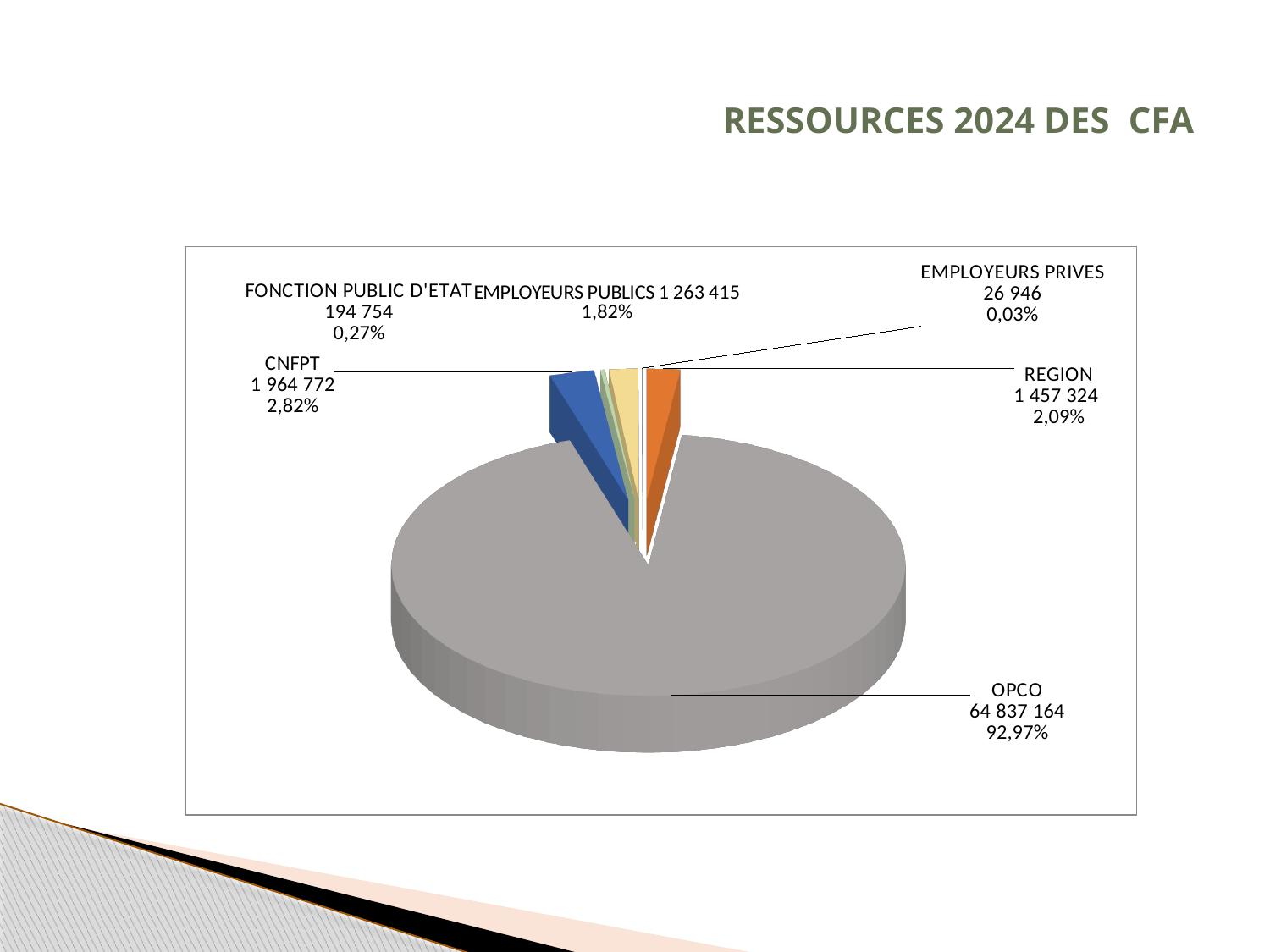
What percentage share does EMPLOYEURS PUBLICS have? 1,82% What is the value for FONCTION PUBLIC D'ETAT? 194 754 What percentage share does CNFPT have? 2,82% Which category has the largest share of the pie? OPCO Which category has the smallest share of the pie? EMPLOYEURS PRIVES What is the value for OPCO? 64 837 164 Which is larger, the value for CNFPT or the value for REGION? CNFPT What is the difference between the value for CNFPT and the value for REGION? 507 448 What is the value for REGION? 1 457 324 What type of chart is shown on the slide? Pie chart How many categories are shown in the pie chart? 6 What percentage share does EMPLOYEURS PRIVES have? 0,03%